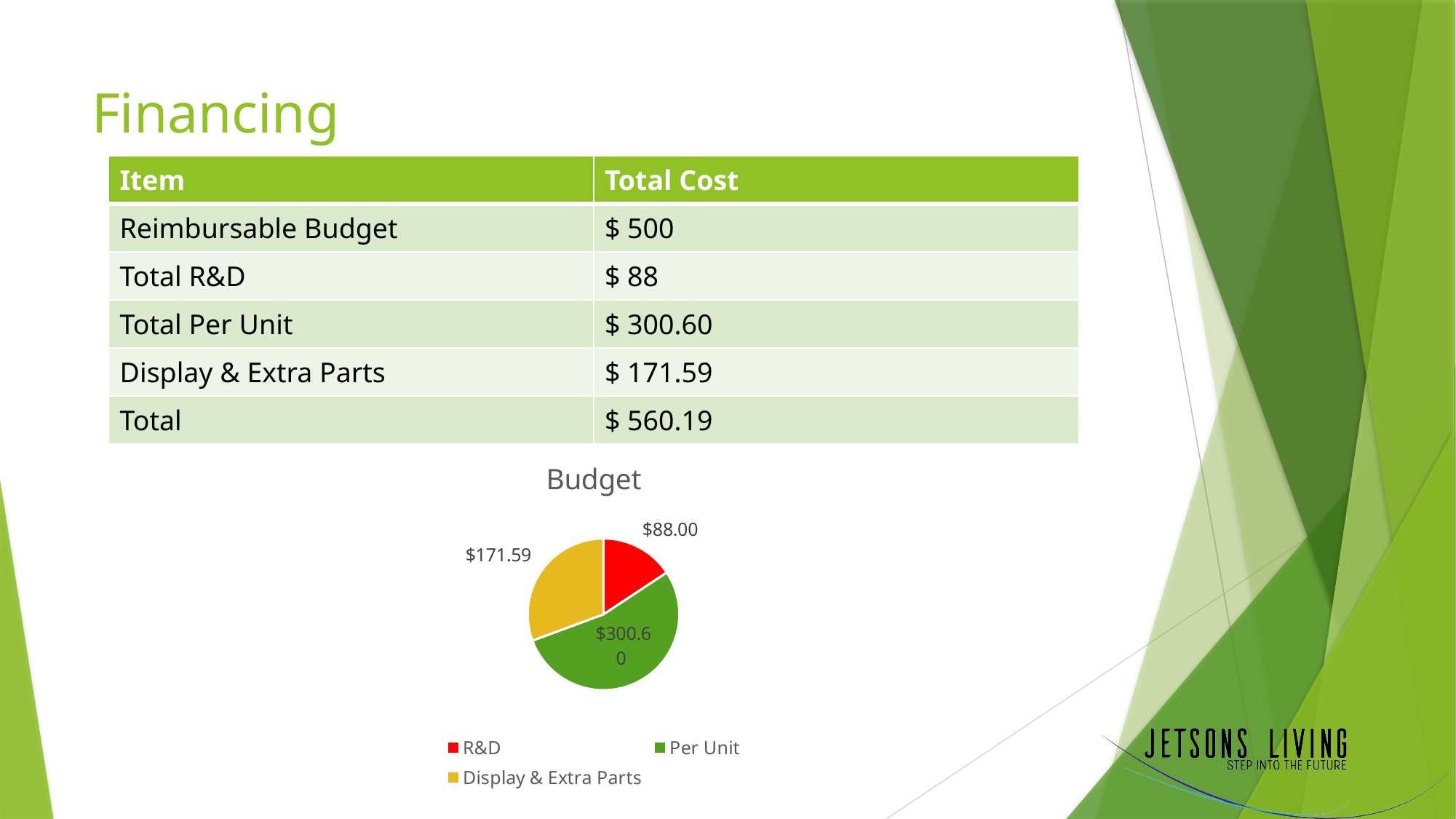
What is the value of the Display & Extra Parts slice in the Budget pie chart? $171.59 Which category has the largest slice in the Budget pie chart? Per Unit Which category has the smallest slice in the Budget pie chart? R&D What colour is the Display & Extra Parts slice in the Budget pie chart? yellow Which is larger in the Budget pie chart, Display & Extra Parts or R&D? Display & Extra Parts What is the value of the Per Unit slice in the Budget pie chart? $300.60 What is the title of the chart? Budget What is the difference between the Per Unit and R&D values in the Budget pie chart? $212.60 What is the value of the R&D slice in the Budget pie chart? $88.00 How many entries does the legend of the Budget pie chart list? 3 How many slices does the Budget pie chart have? 3 What type of chart is shown on the slide? pie chart